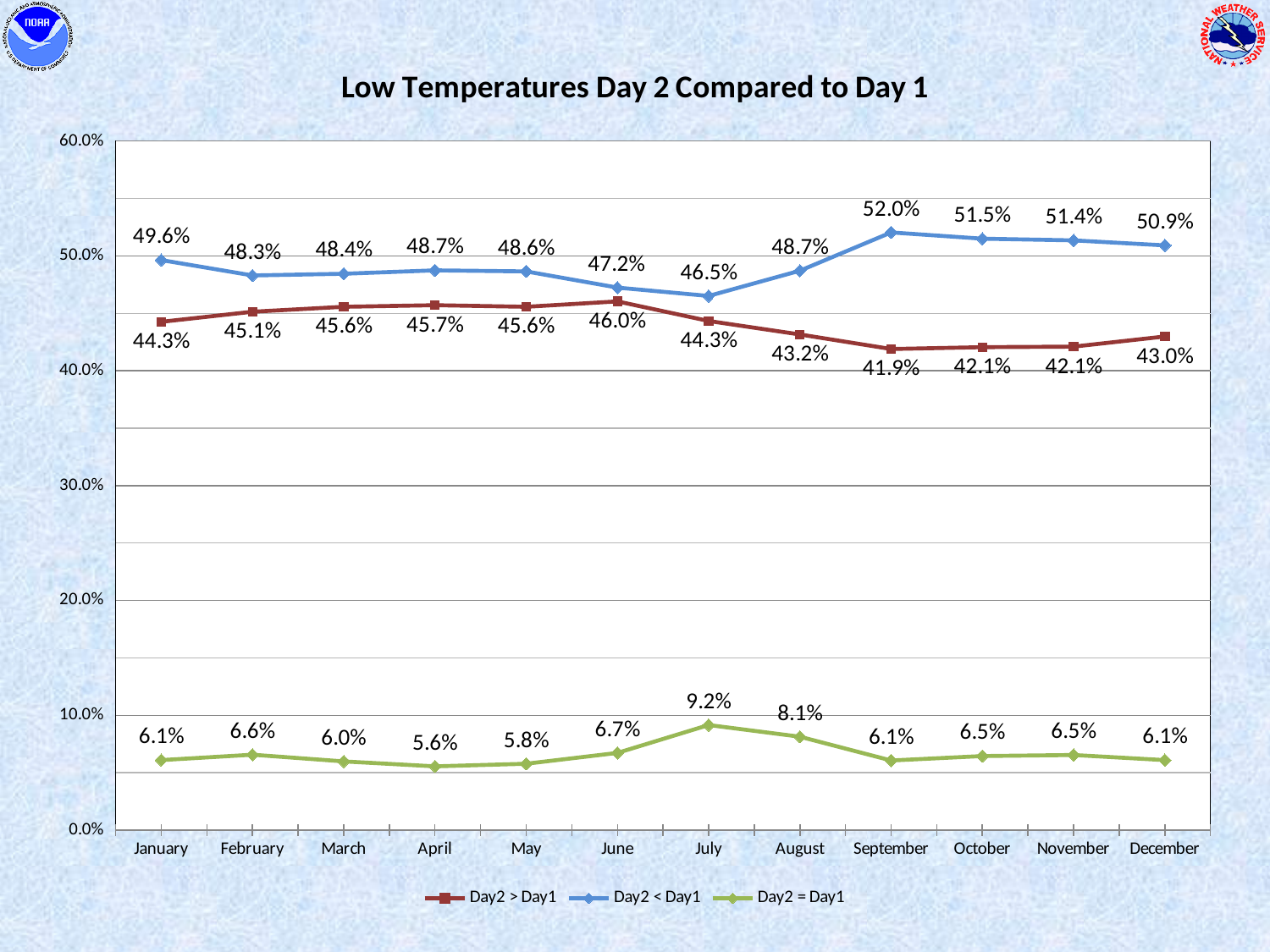
In which month is the Day2 > Day1 series at its lowest? September What is the title of the chart? Low Temperatures Day 2 Compared to Day 1 What is the difference between the Day2 < Day1 and Day2 > Day1 values in September? 10.1% How many series does the legend list? 3 Which is larger in January: the Day2 < Day1 value or the Day2 > Day1 value? Day2 < Day1 In which month is the Day2 < Day1 series at its lowest? July What is the value of the Day2 = Day1 series in July? 9.2% How many months are plotted on the x axis? 12 What is the value of the Day2 < Day1 series in September? 52.0% What is the value of the Day2 > Day1 series in June? 46.0% In which month is the Day2 = Day1 series at its highest? July What type of chart is shown on the slide? Line chart